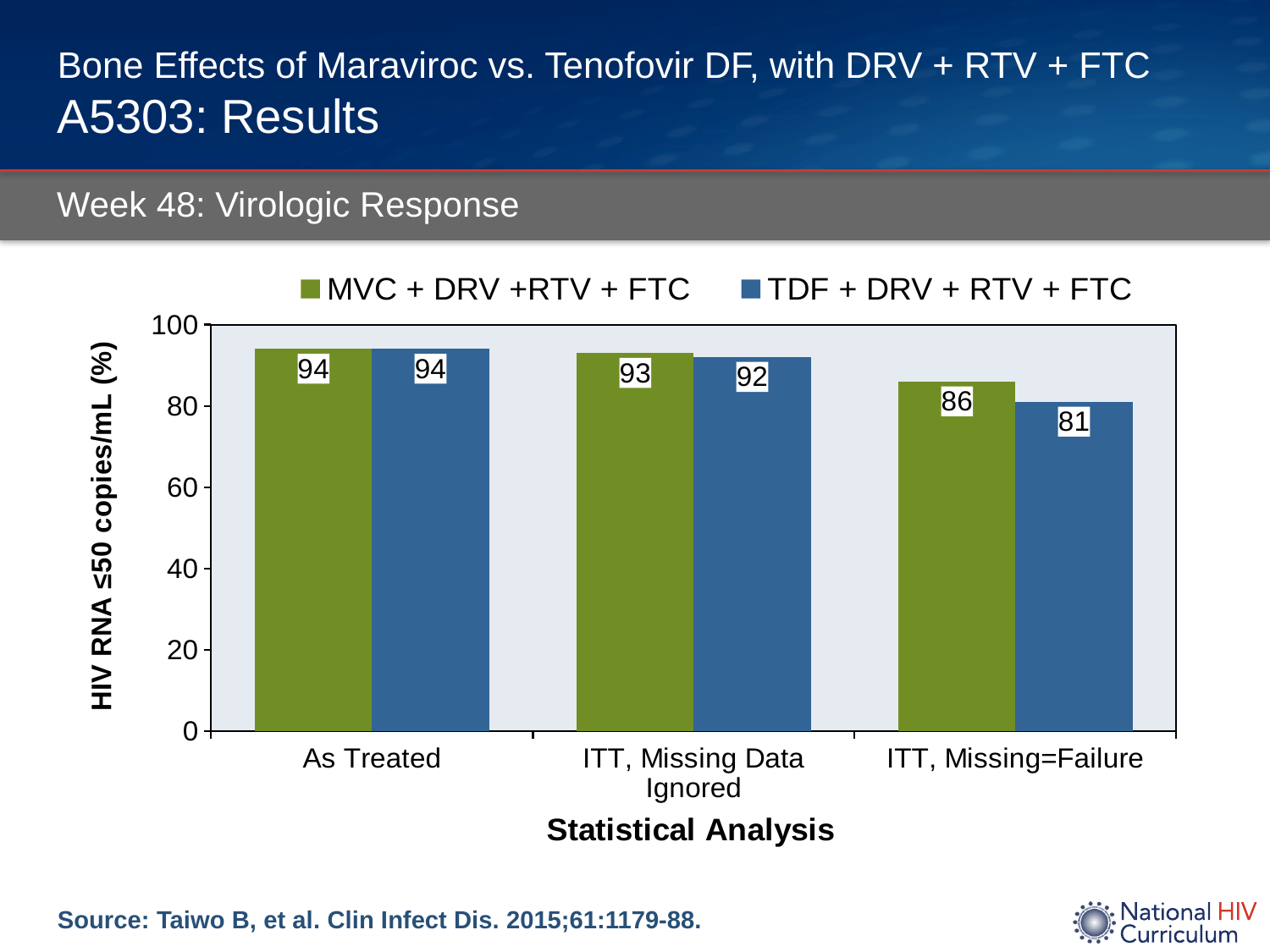
What is the label of the y axis? HIV RNA ≤50 copies/mL (%) What is the value for TDF + DRV + RTV + FTC in the ITT, Missing Data Ignored analysis? 92 What is the value for MVC + DRV + RTV + FTC in the As Treated analysis? 94 How many series does the legend list? 2 How many statistical analysis categories are shown on the x axis? 3 What is the value for MVC + DRV + RTV + FTC in the ITT, Missing=Failure analysis? 86 In the ITT, Missing=Failure analysis, which series has the larger value, MVC + DRV + RTV + FTC or TDF + DRV + RTV + FTC? MVC + DRV + RTV + FTC What kind of chart is shown on the slide? Bar chart What is the value for TDF + DRV + RTV + FTC in the ITT, Missing=Failure analysis? 81 What is the difference between the MVC and TDF values in the ITT, Missing Data Ignored analysis? 1 What is the difference between the MVC and TDF values in the ITT, Missing=Failure analysis? 5 Which statistical analysis has the lowest value for TDF + DRV + RTV + FTC? ITT, Missing=Failure